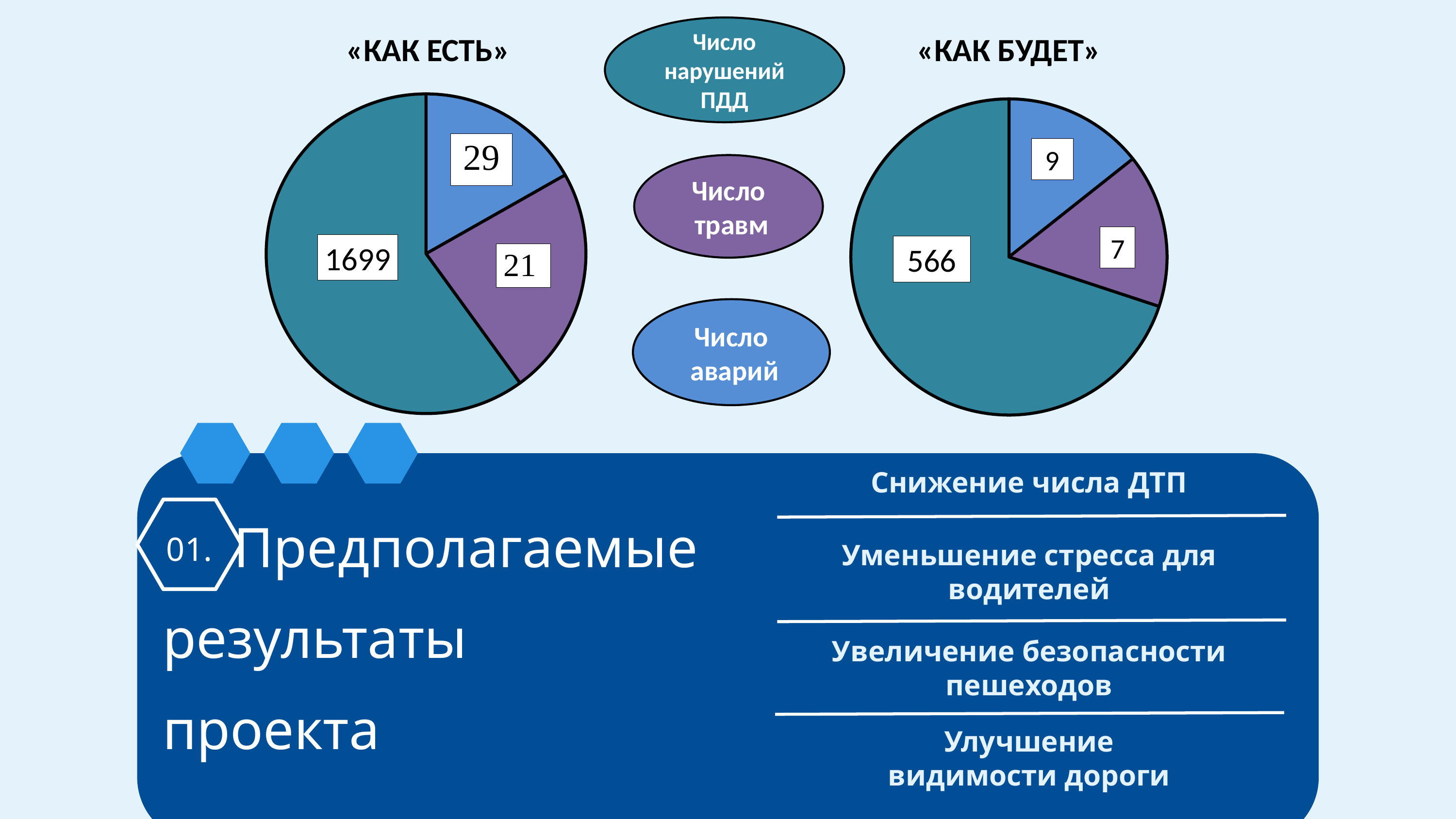
In the «КАК БУДЕТ» pie chart, what is the value for Число нарушений ПДД? 566 In the «КАК ЕСТЬ» pie chart, which category has the largest value? Число нарушений ПДД What type of chart is used for «КАК ЕСТЬ» and «КАК БУДЕТ»? Pie chart In the «КАК ЕСТЬ» pie chart, what is the value for Число травм? 21 In the «КАК ЕСТЬ» pie chart, what is the value for Число нарушений ПДД? 1699 In the «КАК ЕСТЬ» pie chart, which is larger: Число аварий or Число травм? Число аварий In the «КАК БУДЕТ» pie chart, which category has the smallest value? Число травм How many categories does each pie chart on the slide contain? 3 What is the difference between Число нарушений ПДД in the «КАК ЕСТЬ» chart and in the «КАК БУДЕТ» chart? 1133 In the «КАК ЕСТЬ» pie chart, what is the value for Число аварий? 29 In the «КАК БУДЕТ» pie chart, what is the value for Число травм? 7 In the «КАК БУДЕТ» pie chart, what is the value for Число аварий? 9